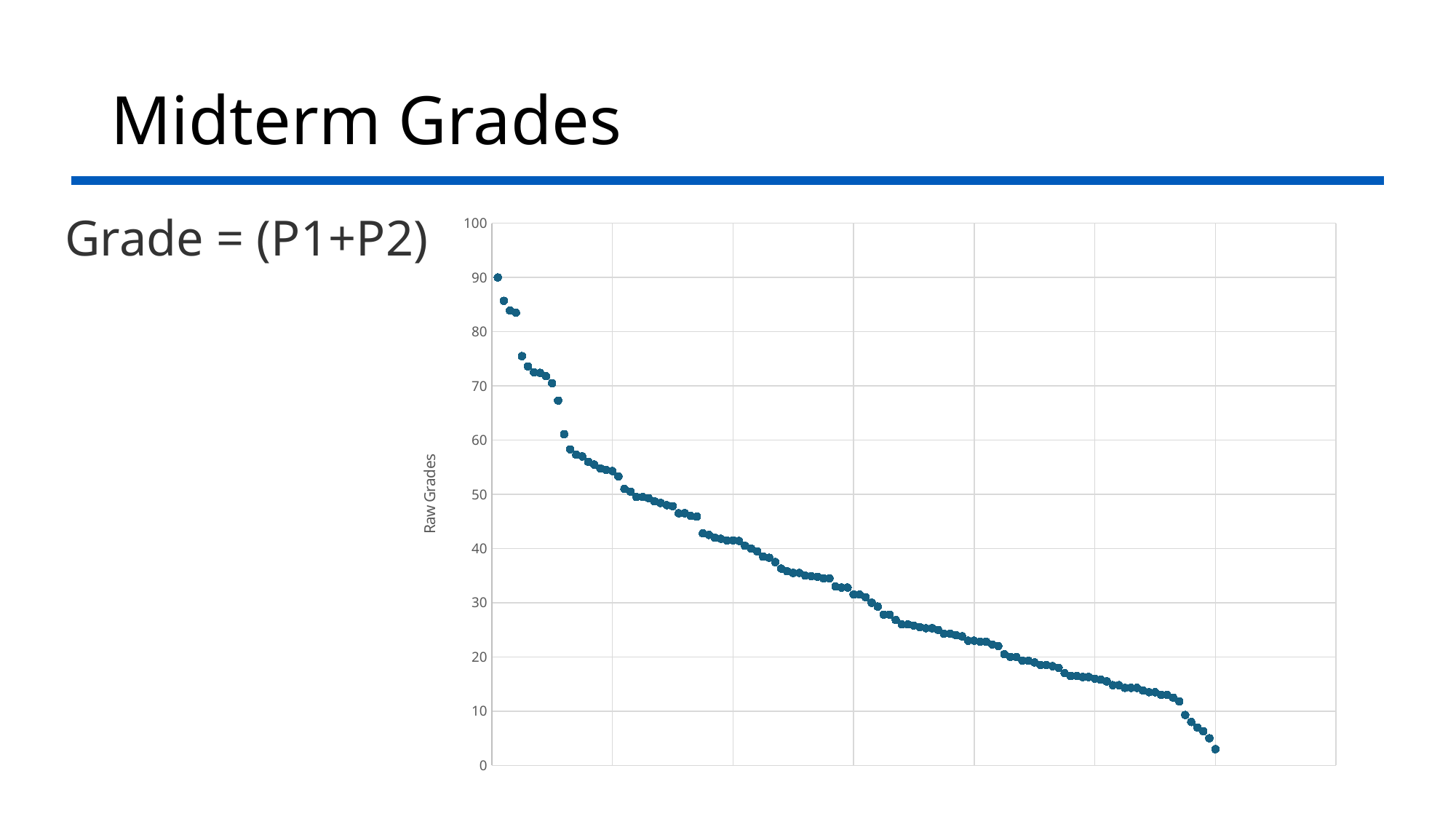
What is the label on the vertical axis of the chart? Raw Grades Is the highest plotted value greater or less than 80? greater Is the lowest plotted value greater or less than 10? less What kind of chart is shown on the slide? scatter chart What is the maximum value shown on the vertical axis? 100 Which point has the higher value, the leftmost point or the rightmost point? the leftmost point Do the plotted values rise or fall from left to right along the x axis? fall Is the leftmost point's value greater or less than 50? greater